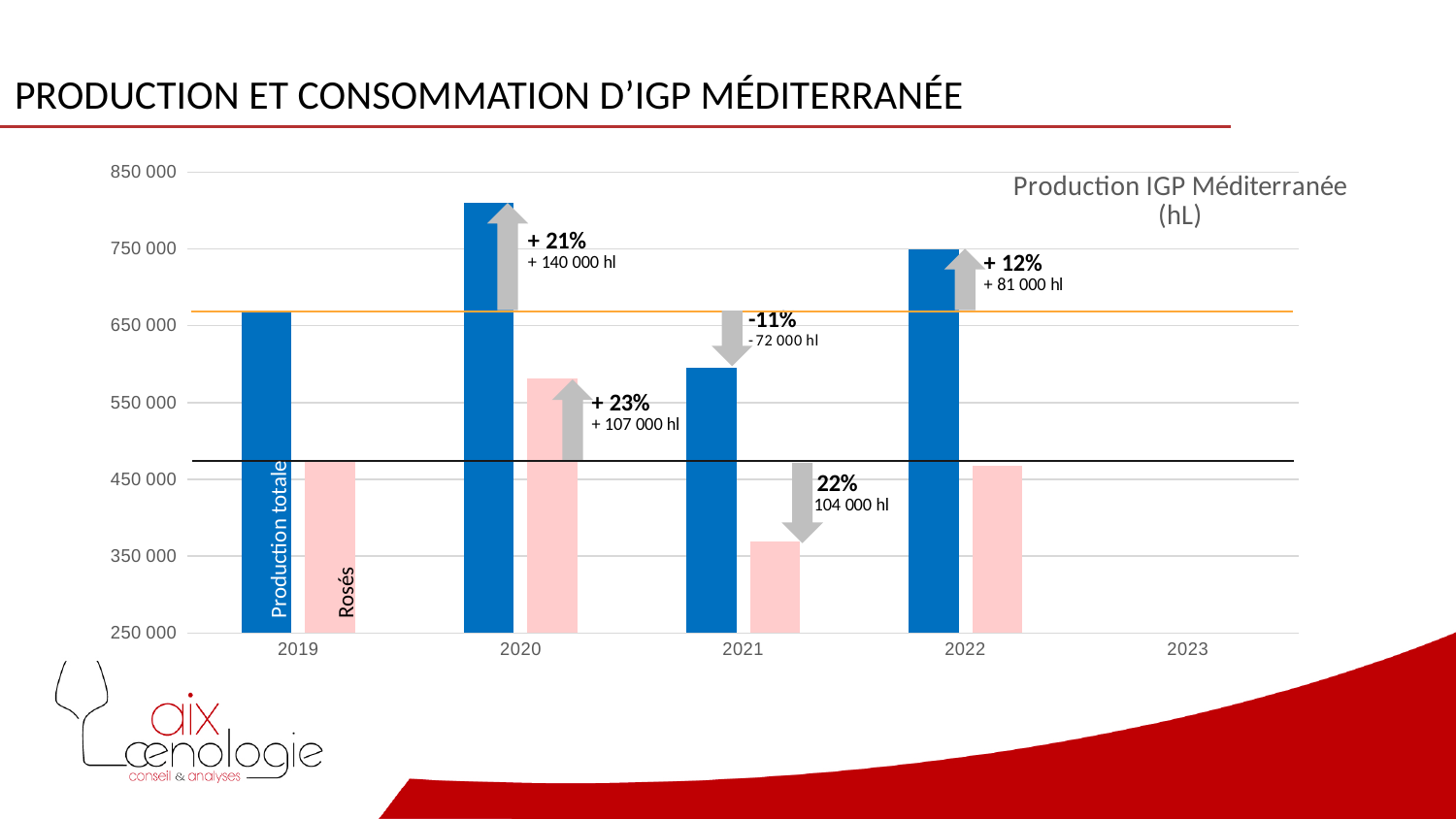
What kind of chart is shown on the slide? bar chart By how many hectolitres did Production totale change between 2019 and 2020, according to the annotation? + 140 000 hl How many series does the chart show (Production totale and Rosés)? 2 In which year is Production totale the lowest among the years with bars? 2021 Is the value for Production totale in 2020 greater or less than 750 000? greater In which year is the Rosés bar the lowest? 2021 What percentage change is annotated for Rosés between 2019 and 2020? + 23% What is the title of the chart? Production IGP Méditerranée (hL) What percentage change in Production totale is annotated between 2019 and 2020? + 21% In which year is Production totale the highest? 2020 What percentage change in Production totale is annotated between 2020 and 2021? -11% By how many hectolitres did Production totale change between 2021 and 2022, according to the annotation? + 81 000 hl